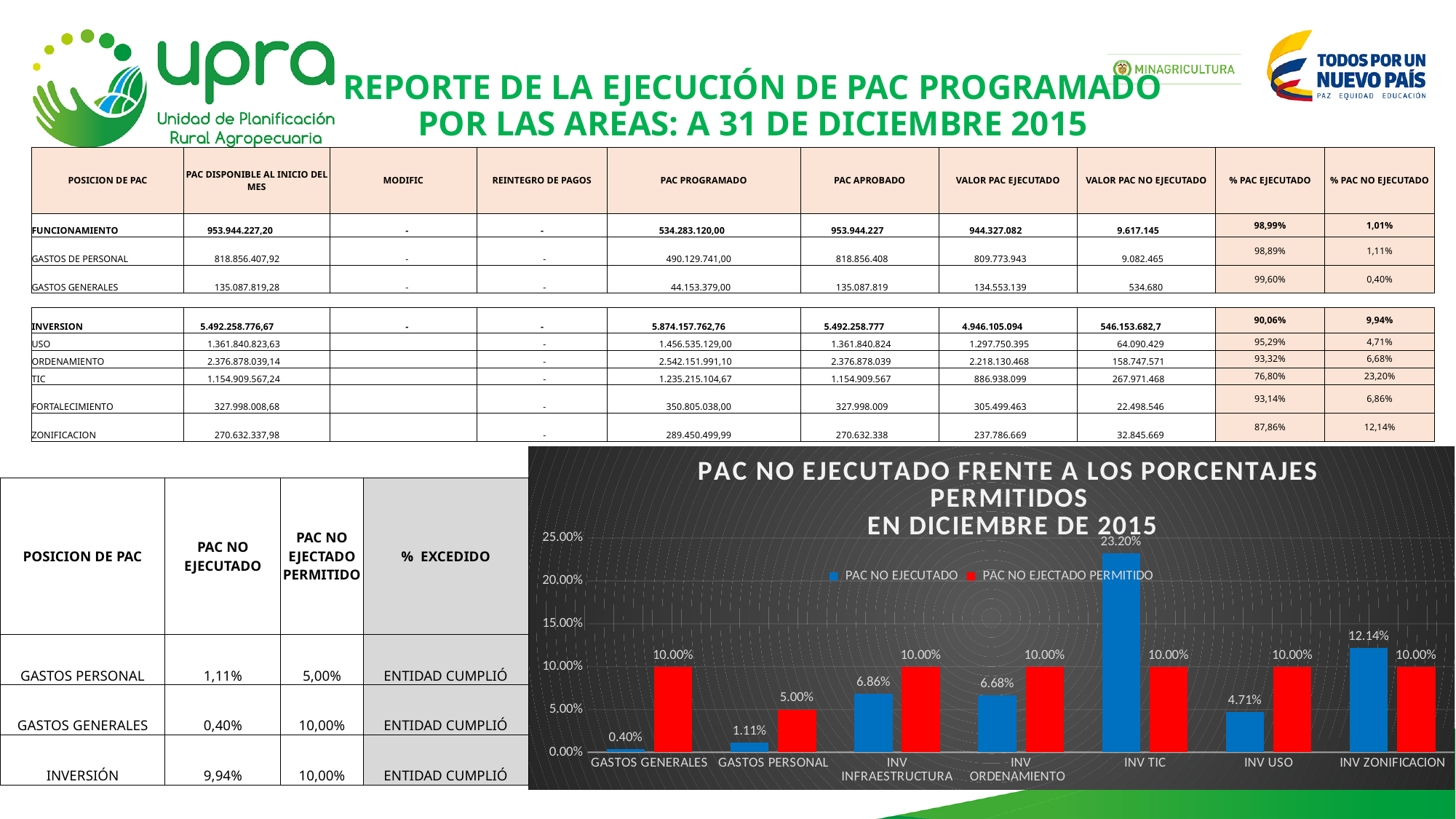
What type of chart is shown on the slide? bar chart What is the PAC NO EJECTADO PERMITIDO value for GASTOS PERSONAL? 5.00% What is the difference between the PAC NO EJECUTADO value for INV TIC and its PAC NO EJECTADO PERMITIDO value? 13.20% Which category has the highest PAC NO EJECUTADO value? INV TIC How many categories are shown on the x axis of the chart? 7 What is the PAC NO EJECUTADO value for GASTOS GENERALES? 0.40% How many series does the chart legend list? 2 What colour are the PAC NO EJECTADO PERMITIDO bars in the chart? red Which category has the lowest PAC NO EJECUTADO value? GASTOS GENERALES What is the PAC NO EJECUTADO value for INV TIC? 23.20% Which is larger for INV ZONIFICACION: PAC NO EJECUTADO or PAC NO EJECTADO PERMITIDO? PAC NO EJECUTADO Is the PAC NO EJECUTADO value for INV USO greater or less than 5.00%? less